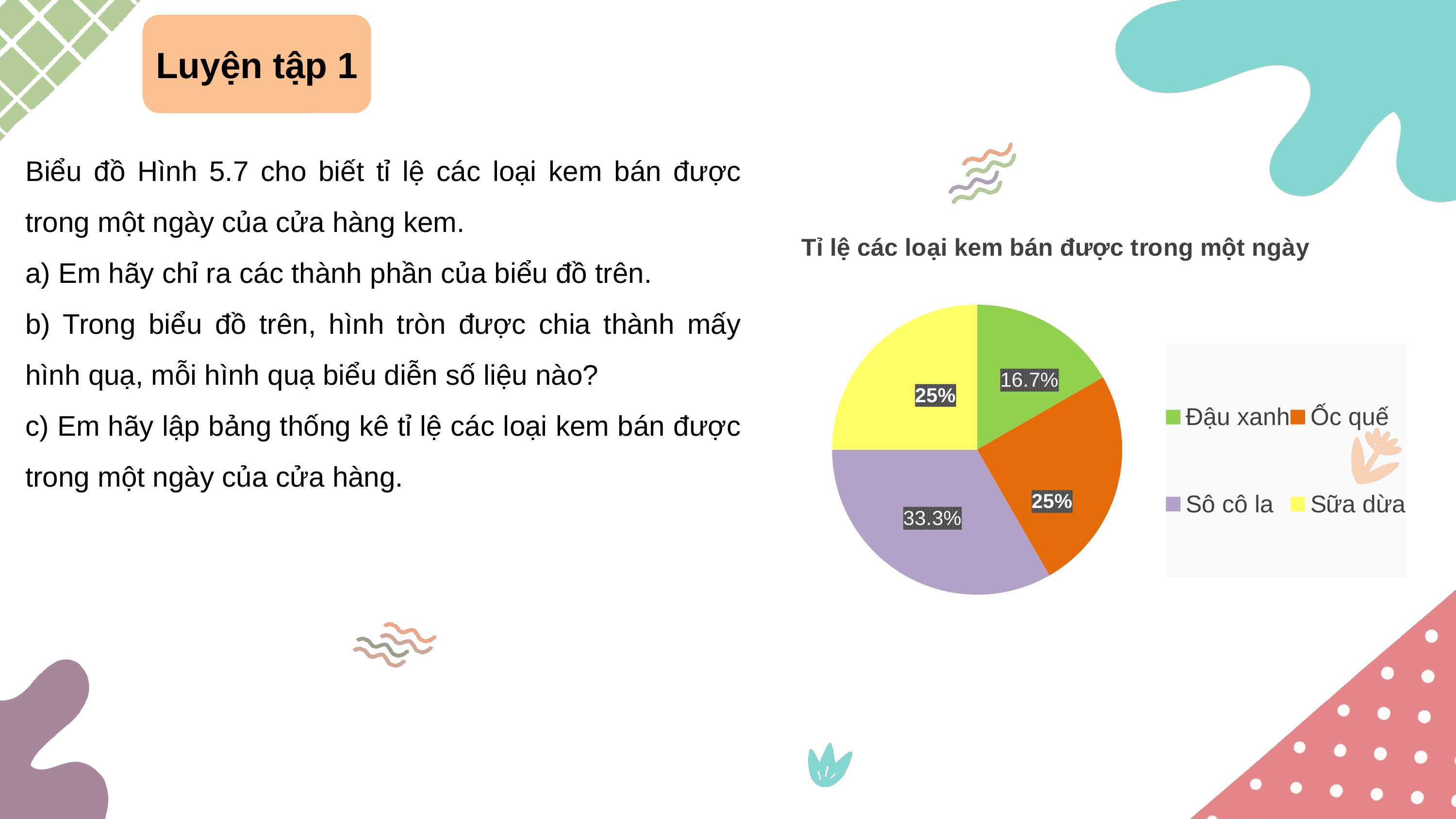
What percentage of the pie is Sữa dừa? 25% What percentage of the pie is Sô cô la? 33.3% What percentage of the pie is Đậu xanh? 16.7% How many slices does the pie chart have? 4 Which colour represents Sữa dừa in the chart? Yellow What is the difference in percentage points between Sô cô la and Đậu xanh? 16.6 What is the title of the chart? Tỉ lệ các loại kem bán được trong một ngày Which ice cream type has the largest share of the pie? Sô cô la What percentage of the pie is Ốc quế? 25% What kind of chart is shown on the slide? Pie chart Which ice cream type has the smallest share of the pie? Đậu xanh Which has a larger share, Sô cô la or Ốc quế? Sô cô la